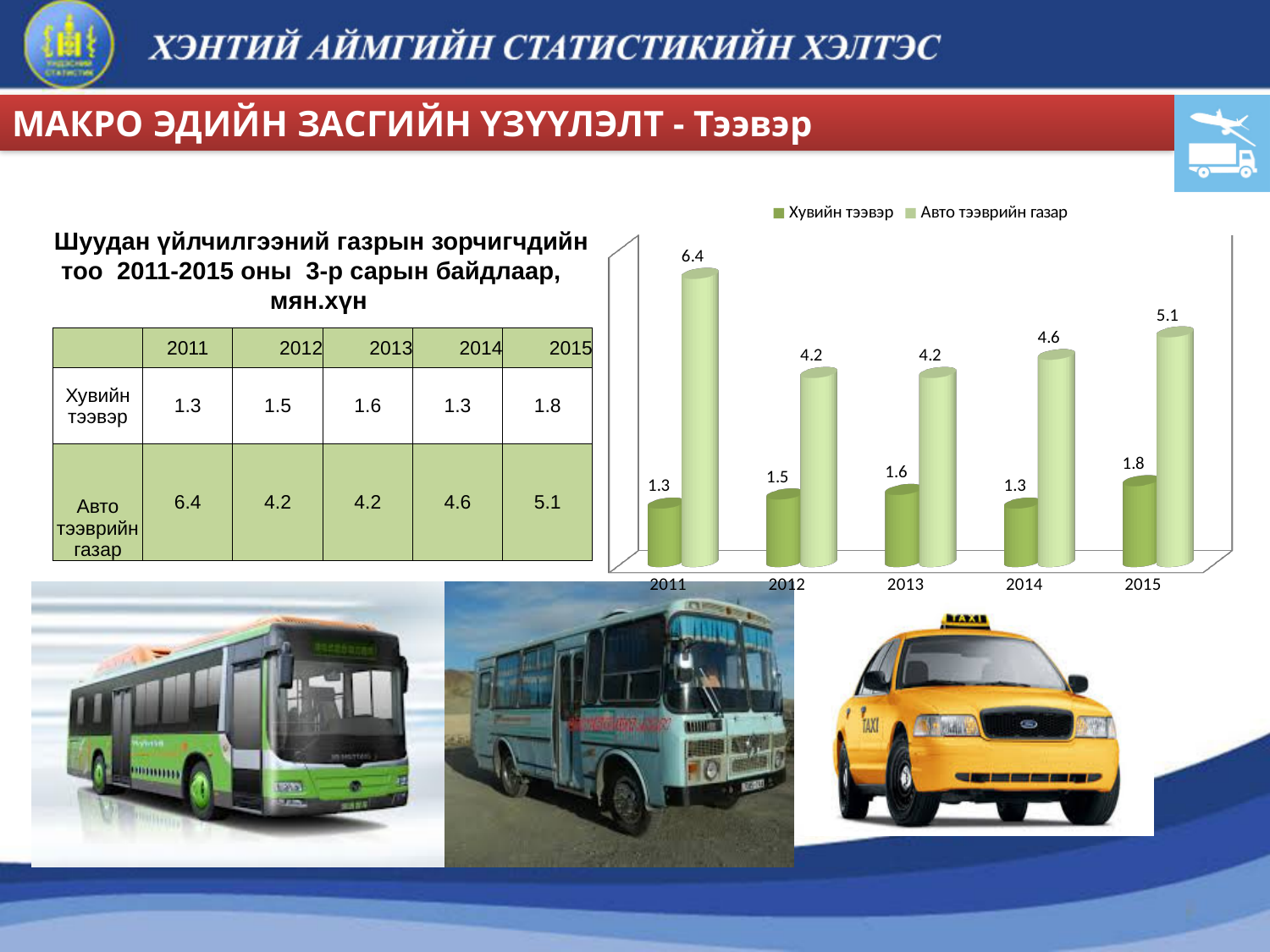
How many years are shown on the x axis of the chart? 5 What is the difference between the Авто тээврийн газар values for 2011 and 2012? 2.2 In which year is the value for Авто тээврийн газар highest? 2011 How many series does the chart legend list? 2 What is the value for Хувийн тээвэр in 2015? 1.8 What is the value for Хувийн тээвэр in 2013? 1.6 In which year is the value for Хувийн тээвэр highest? 2015 What is the value for Авто тээврийн газар in 2011? 6.4 Which is larger in 2014: Хувийн тээвэр or Авто тээврийн газар? Авто тээврийн газар What kind of chart is shown on the slide? Bar chart What is the difference between Авто тээврийн газар and Хувийн тээвэр in 2015? 3.3 Does the value for Авто тээврийн газар rise or fall from 2013 to 2015? Rise